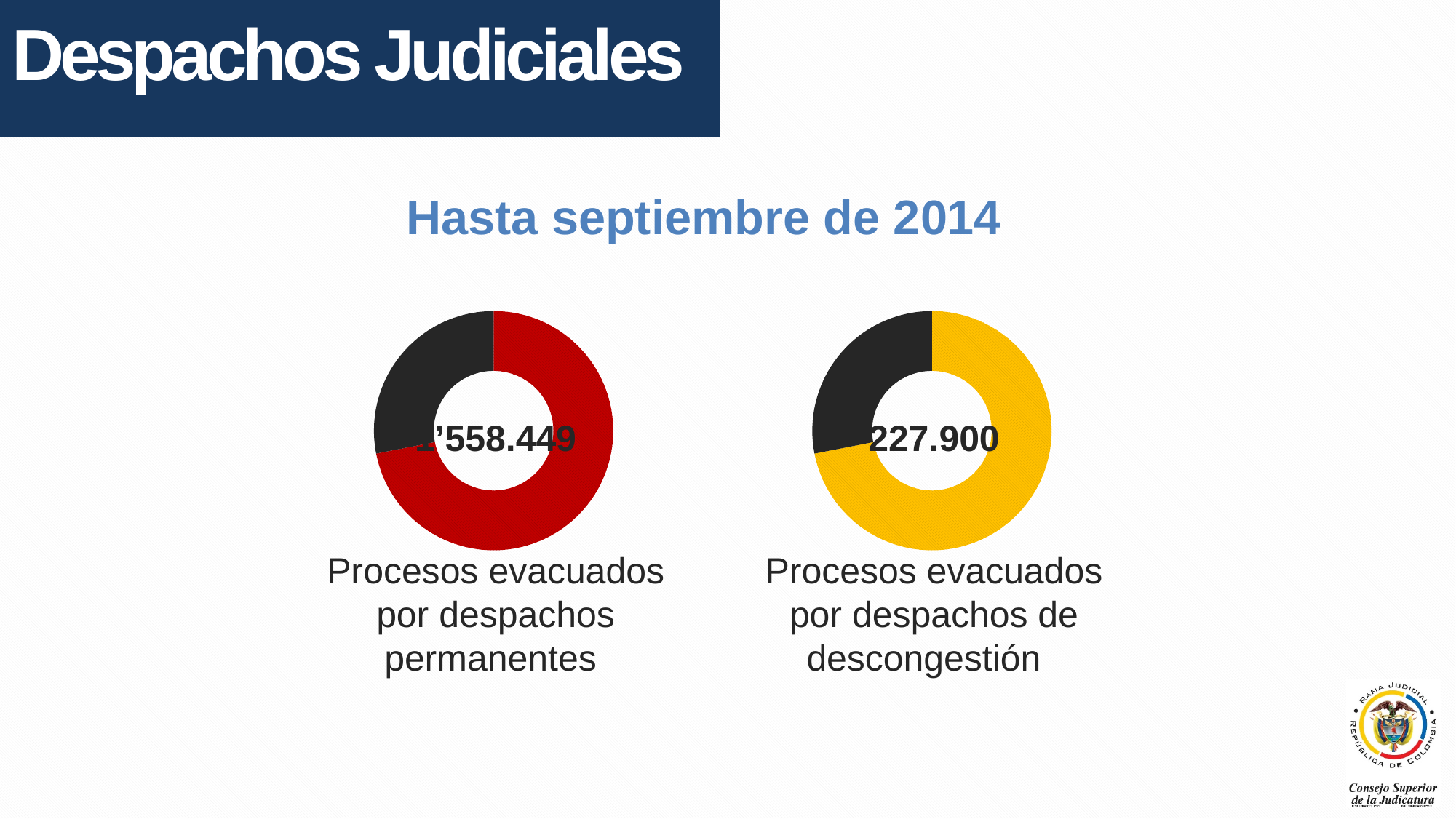
How many slices does the doughnut chart 'Procesos evacuados por despachos de descongestión' have? 2 What colour is the larger slice of the right doughnut chart? Yellow What kind of chart is used for 'Procesos evacuados por despachos permanentes'? Doughnut chart How many doughnut charts are shown on the slide? 2 In the chart 'Procesos evacuados por despachos de descongestión', what number is printed in the centre of the doughnut? 227.900 What kind of chart is used for 'Procesos evacuados por despachos de descongestión'? Doughnut chart In the chart 'Procesos evacuados por despachos de descongestión', which slice is larger, the yellow one or the dark one? The yellow one What is the caption below the left doughnut chart? Procesos evacuados por despachos permanentes In the chart 'Procesos evacuados por despachos permanentes', which slice is larger, the red one or the dark one? The red one How many slices does the doughnut chart 'Procesos evacuados por despachos permanentes' have? 2